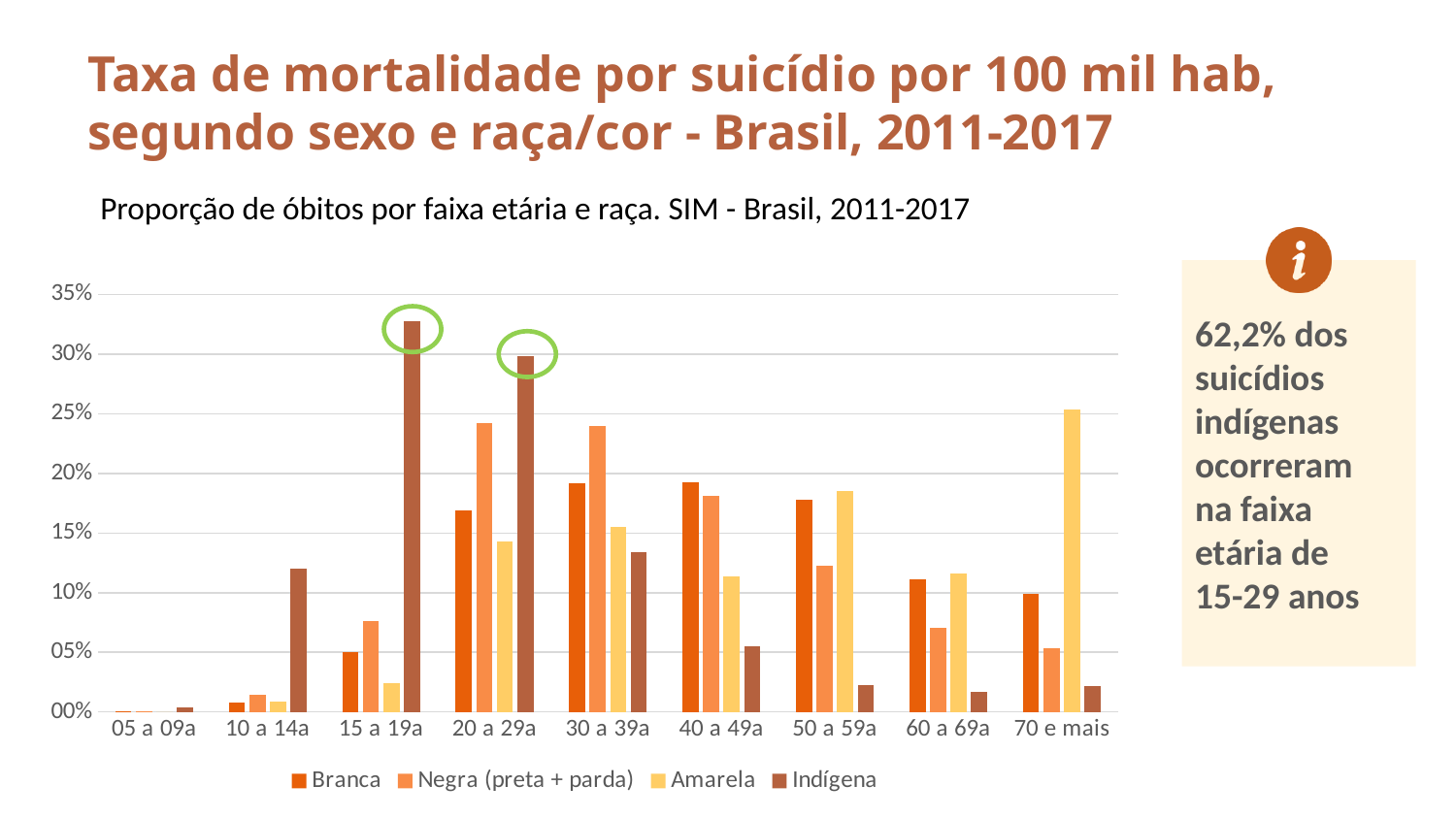
Is the Indígena value for 15 a 19a greater or less than 30%? greater In which age group is the Indígena series highest? 15 a 19a How many series does the legend list? 4 In which age group is the Amarela series highest? 70 e mais Is the Amarela value for 70 e mais greater or less than 20%? greater In which age group is the Negra (preta + parda) series highest? 20 a 29a How many age-group categories are shown on the x axis? 9 What kind of chart is shown on the slide? bar chart What is the subtitle printed above the chart? Proporção de óbitos por faixa etária e raça. SIM - Brasil, 2011-2017 Is the Branca value for 70 e mais greater or less than 15%? less In which age group is the Indígena series lowest? 05 a 09a For the 50 a 59a age group, which is larger: Amarela or Negra (preta + parda)? Amarela